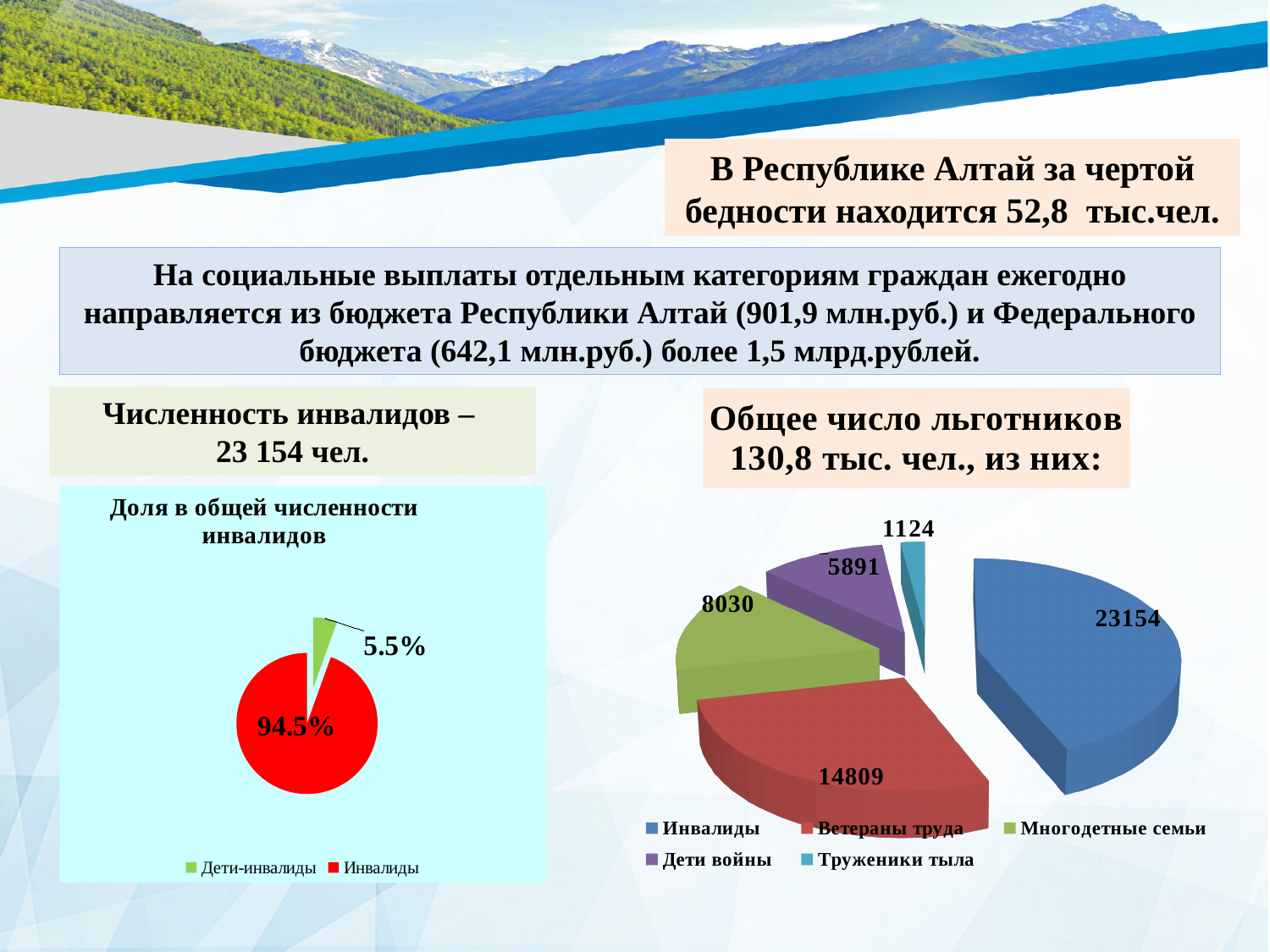
In the right pie chart (under "Общее число льготников"), what is the difference between the values for Инвалиды and Ветераны труда? 8345 How many series does the legend of the left pie chart ("Доля в общей численности инвалидов") list? 2 In the right pie chart (under "Общее число льготников"), which category has the smallest value? Труженики тыла What kind of chart is the chart on the left of the slide? Pie chart In the left pie chart titled "Доля в общей численности инвалидов", what share is shown for Дети-инвалиды? 5.5% In the left pie chart titled "Доля в общей численности инвалидов", what share is shown for Инвалиды? 94.5% How many categories does the legend of the right pie chart (under "Общее число льготников") list? 5 In the right pie chart (under "Общее число льготников"), which is larger: Многодетные семьи or Дети войны? Многодетные семьи In the right pie chart (under "Общее число льготников"), what is the value for Ветераны труда? 14809 In the right pie chart (under "Общее число льготников"), which category has the largest value? Инвалиды In the right pie chart (under "Общее число льготников"), what is the value for Дети войны? 5891 In the right pie chart (under "Общее число льготников"), what is the value for Многодетные семьи? 8030